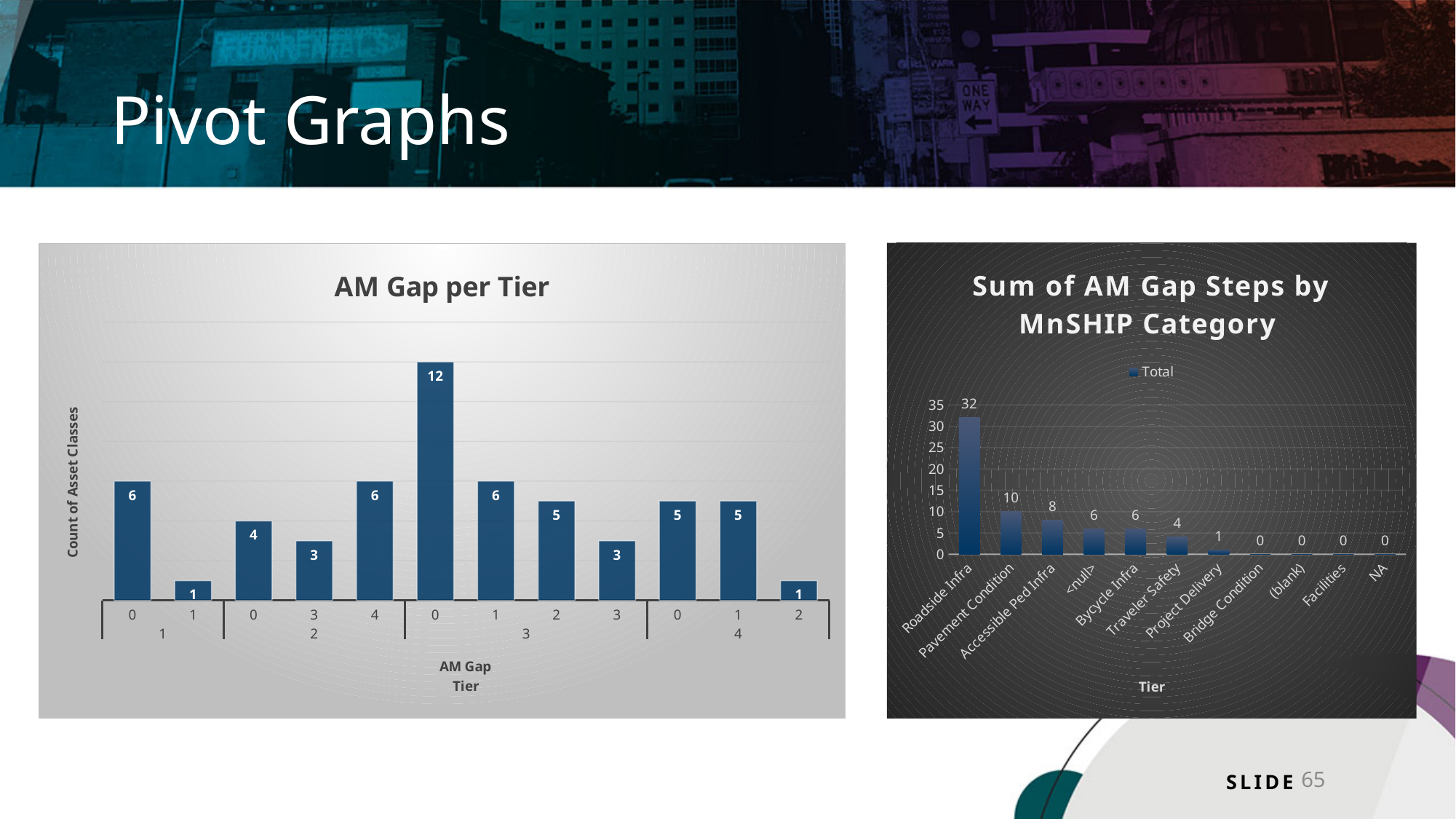
In the 'AM Gap per Tier' chart, how many bars are plotted in total? 12 In the 'Sum of AM Gap Steps by MnSHIP Category' chart, what is the value for Pavement Condition? 10 In the 'AM Gap per Tier' chart, what kind of chart is shown? Bar chart In the 'Sum of AM Gap Steps by MnSHIP Category' chart, which is larger: Traveler Safety or Project Delivery? Traveler Safety In the 'Sum of AM Gap Steps by MnSHIP Category' chart, which category has the highest value? Roadside Infra In the 'AM Gap per Tier' chart, what is the count of asset classes for AM Gap 4 in Tier 2? 6 In the 'Sum of AM Gap Steps by MnSHIP Category' chart, what series name does the legend show? Total In the 'AM Gap per Tier' chart, what is the difference between the count for AM Gap 0 in Tier 3 and AM Gap 1 in Tier 3? 6 In the 'Sum of AM Gap Steps by MnSHIP Category' chart, what is the value for Roadside Infra? 32 In the 'AM Gap per Tier' chart, what is the count of asset classes for AM Gap 0 in Tier 3? 12 In the 'AM Gap per Tier' chart, which bar has the highest count of asset classes? AM Gap 0 in Tier 3 In the 'Sum of AM Gap Steps by MnSHIP Category' chart, what is the difference between Roadside Infra and Accessible Ped Infra? 24